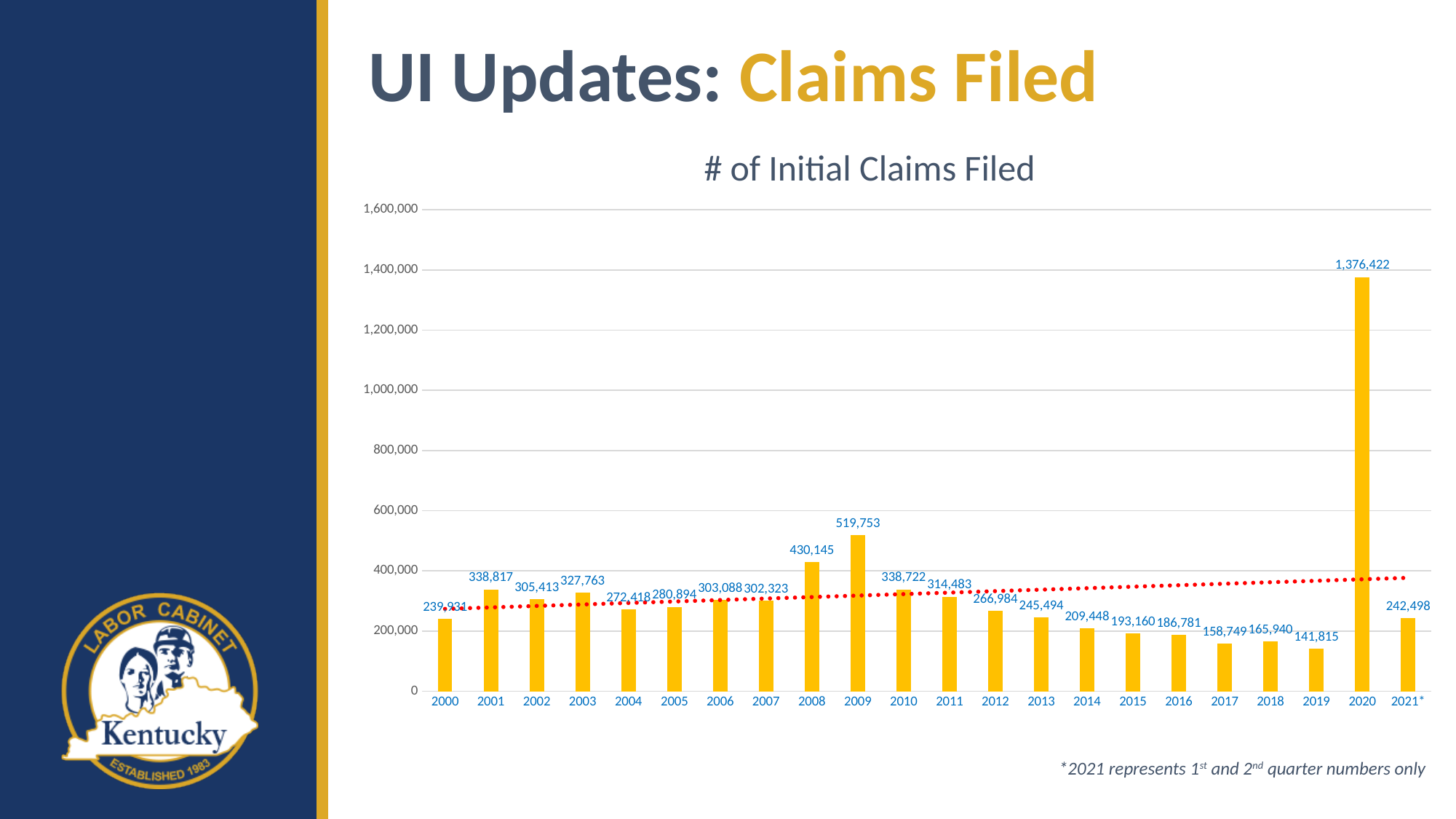
What is the difference between the initial claims filed in 2020 and in 2019? 1,234,607 Do the values rise or fall from 2013 to 2017? fall What is the number of initial claims filed in 2021*? 242,498 How many years are shown on the x axis of the chart? 22 What is the number of initial claims filed in 2020? 1,376,422 Which year had more initial claims filed, 2002 or 2003? 2003 Which year has the highest number of initial claims filed? 2020 What is the number of initial claims filed in 2009? 519,753 What kind of chart is used to show the number of initial claims filed? bar chart Which year has the lowest number of initial claims filed? 2019 What is the difference between the initial claims filed in 2009 and in 2008? 89,608 Is the value for 2020 greater or less than 1,200,000? greater